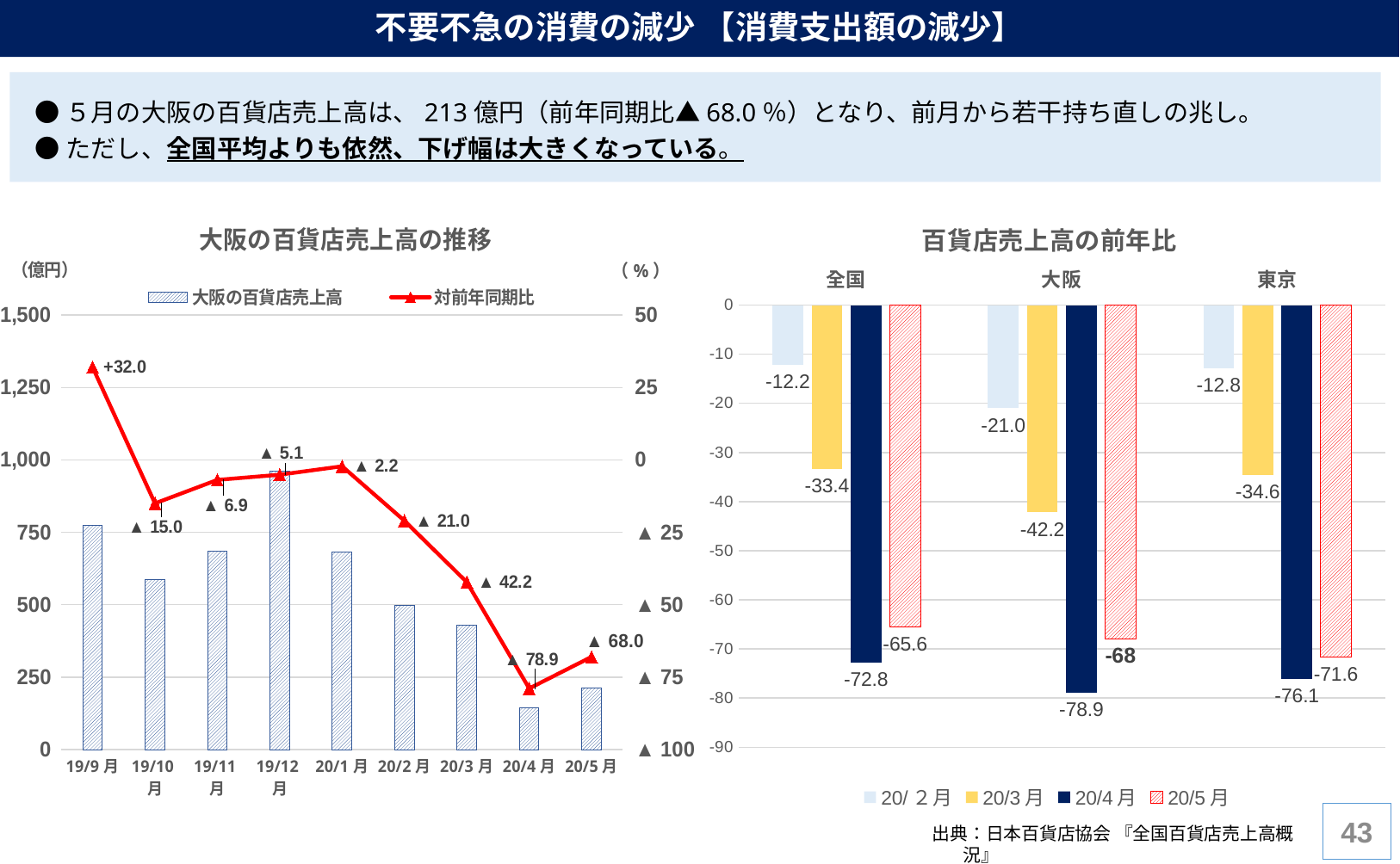
In the chart titled 大阪の百貨店売上高の推移, what is the 対前年同期比 value labelled for 19/9月? +32.0 In the chart titled 百貨店売上高の前年比, how many series does the legend list? 4 In the chart titled 百貨店売上高の前年比, what is the value for 全国 in the 20/5月 series? -65.6 In the chart titled 百貨店売上高の前年比, how many regions are shown on the x axis? 3 In the chart titled 大阪の百貨店売上高の推移, is the 大阪の百貨店売上高 bar for 19/9月 greater or less than 750 (億円)? greater In the chart titled 百貨店売上高の前年比, what is the difference between the 20/5月 values for 東京 and 全国? 6.0 In the chart titled 百貨店売上高の前年比, which region has the lowest value in the 20/4月 series? 大阪 In the chart titled 大阪の百貨店売上高の推移, how many months are shown on the x axis? 9 In the chart titled 百貨店売上高の前年比, what is the value for 東京 in the 20/3月 series? -34.6 In the chart titled 大阪の百貨店売上高の推移, is the 大阪の百貨店売上高 bar for 20/4月 greater or less than 250 (億円)? less In the chart titled 百貨店売上高の前年比, what is the value for 大阪 in the 20/4月 series? -78.9 In the chart titled 大阪の百貨店売上高の推移, what is the 対前年同期比 value labelled for 20/3月? ▲ 42.2